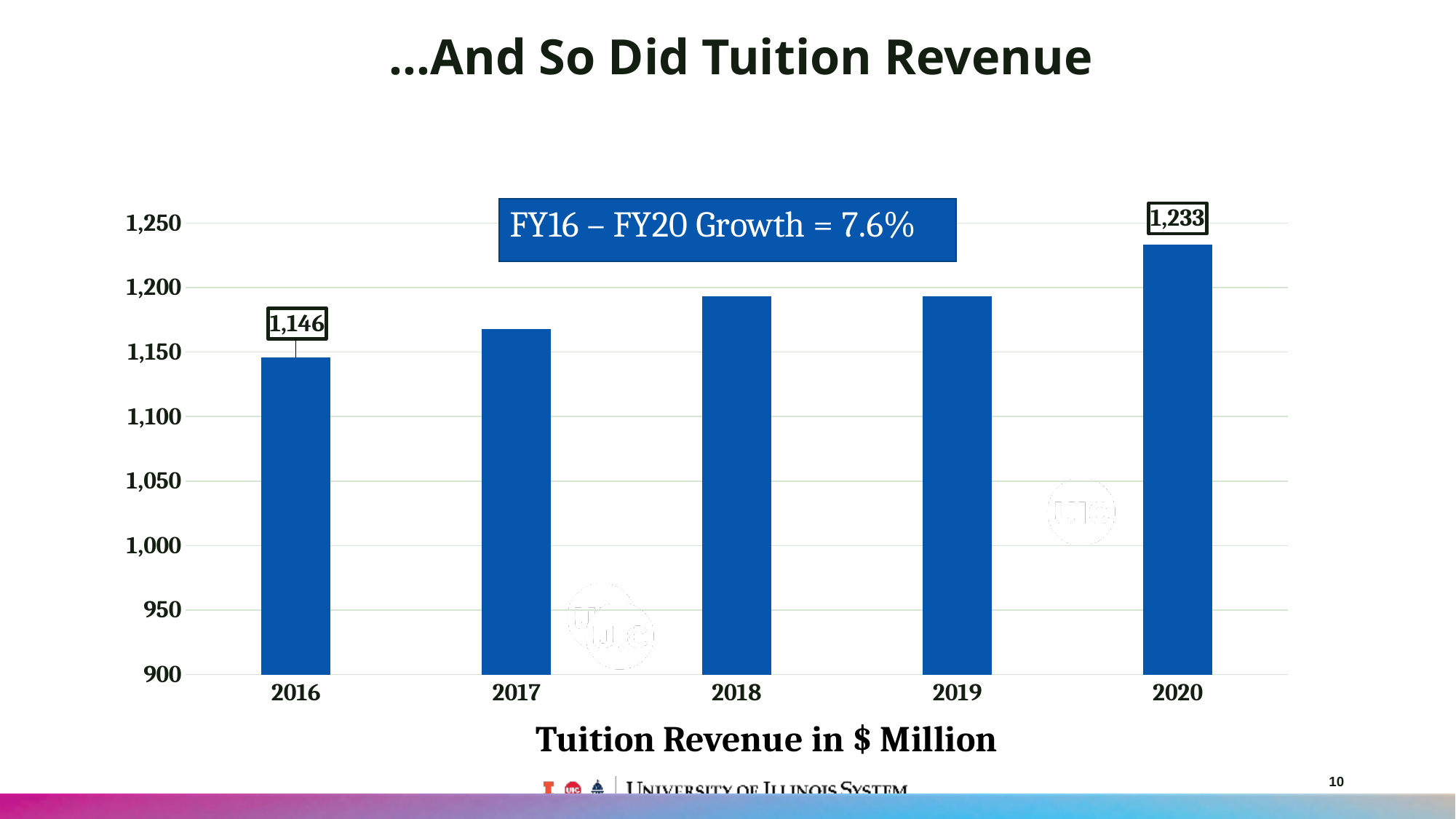
What kind of chart is shown on the slide? Bar chart Which year has the lowest tuition revenue? 2016 Which year has the highest tuition revenue? 2020 Do the tuition revenue values generally rise or fall from 2016 to 2020? Rise What is the tuition revenue value shown for 2016? 1,146 What FY16 – FY20 growth percentage is stated on the chart? 7.6% How many years are shown on the x axis? 5 What is the tuition revenue value shown for 2020? 1,233 Is the value for 2017 greater or less than 1,150? greater Which is larger, the tuition revenue for 2017 or for 2018? 2018 What is the difference between the 2020 and 2016 tuition revenue values? 87 Is the value for 2019 greater or less than 1,200? less